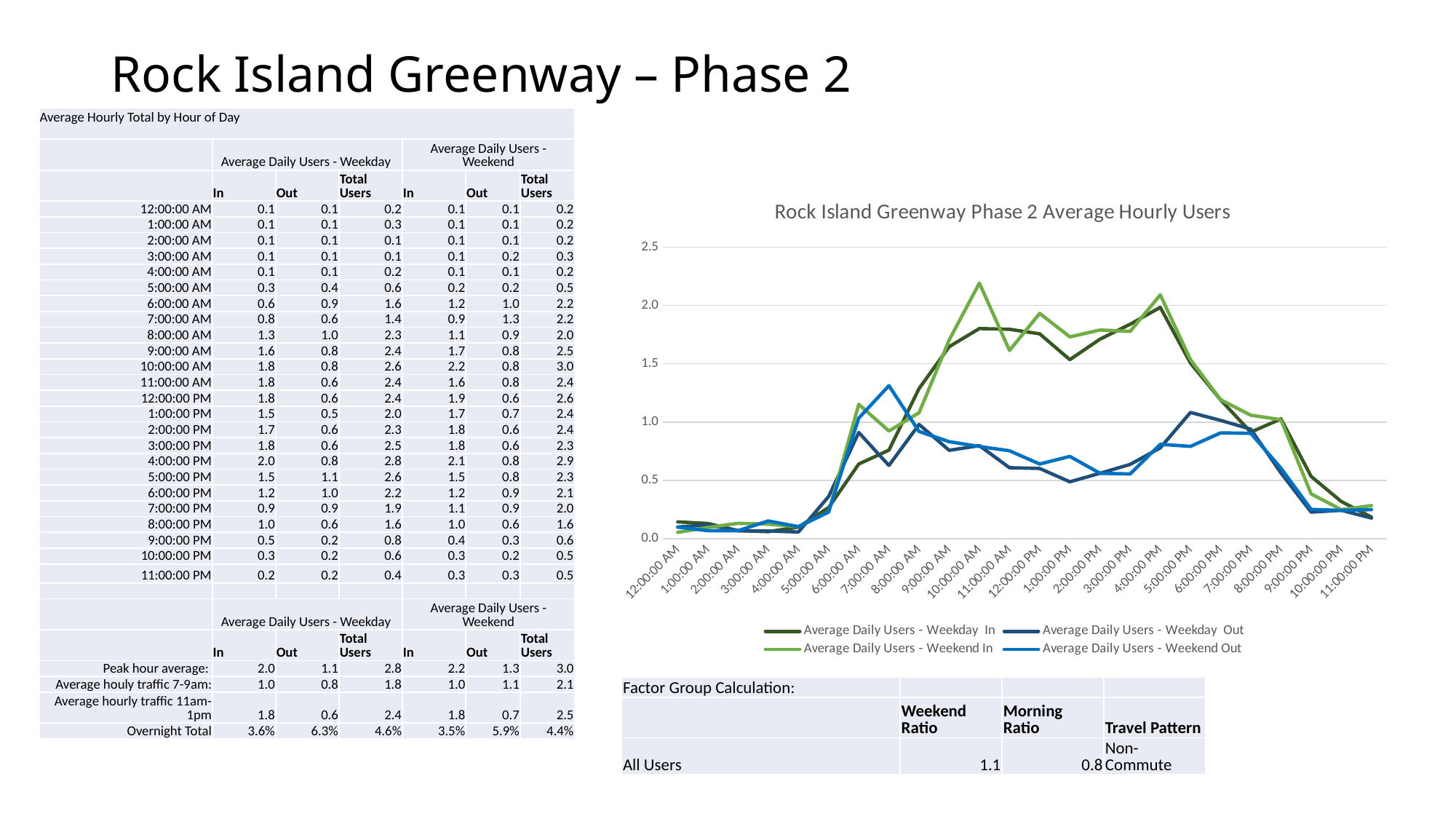
Does the Average Daily Users - Weekday In series rise or fall from 4:00:00 PM to 9:00:00 PM? fall Is the value for Average Daily Users - Weekend In at 10:00:00 AM greater or less than 2.0? greater At 10:00:00 AM, which is larger: Average Daily Users - Weekend In or Average Daily Users - Weekday In? Average Daily Users - Weekend In Is the value for Average Daily Users - Weekday Out at 1:00:00 PM greater or less than 1.0? less Is the value for Average Daily Users - Weekday In at 4:00:00 PM greater or less than 1.5? greater At which hour does the Average Daily Users - Weekend Out series reach its highest value? 7:00:00 AM How many hourly points are plotted along the x axis of the chart? 24 At which hour does the Average Daily Users - Weekend In series reach its highest value? 10:00:00 AM What is the highest value shown on the chart's y axis? 2.5 What is the title of the chart? Rock Island Greenway Phase 2 Average Hourly Users What kind of chart is shown on the slide? line chart How many series does the chart legend list? 4